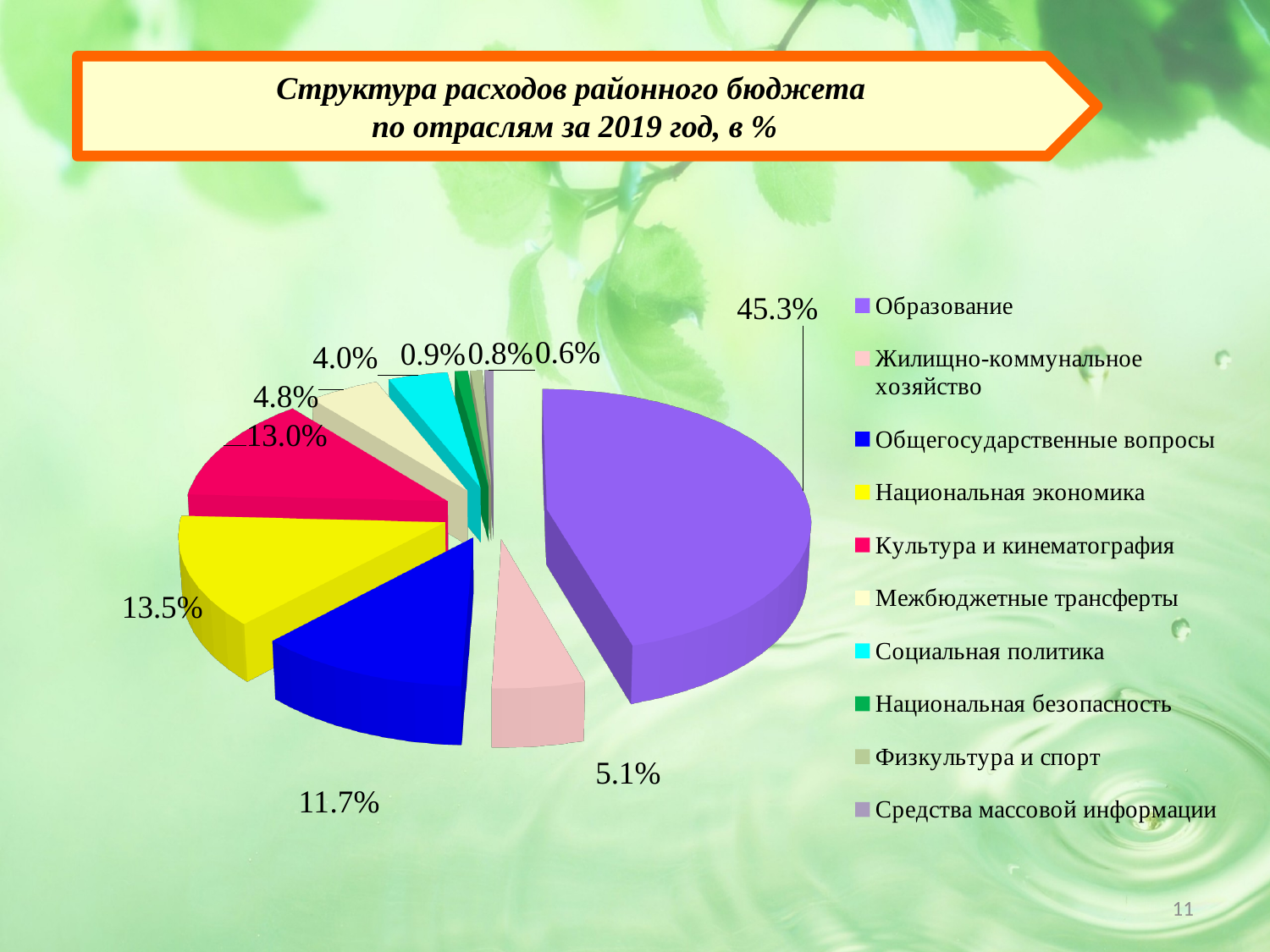
What is the title of the chart on the slide? Структура расходов районного бюджета по отраслям за 2019 год, в % What is the value shown for Культура и кинематография? 13.0% What is the value shown for Жилищно-коммунальное хозяйство? 5.1% What is the value shown for Общегосударственные вопросы? 11.7% Which category has the smallest share of expenditure? Средства массовой информации What share of the district budget expenditure goes to Образование? 45.3% How many categories does the legend list? 10 What type of chart is shown on the slide? pie chart Which category has the largest share of expenditure? Образование Which is larger, the share for Национальная экономика or the share for Общегосударственные вопросы? Национальная экономика What is the value shown for Национальная экономика? 13.5% What is the difference between the shares for Образование and Национальная экономика? 31.8%